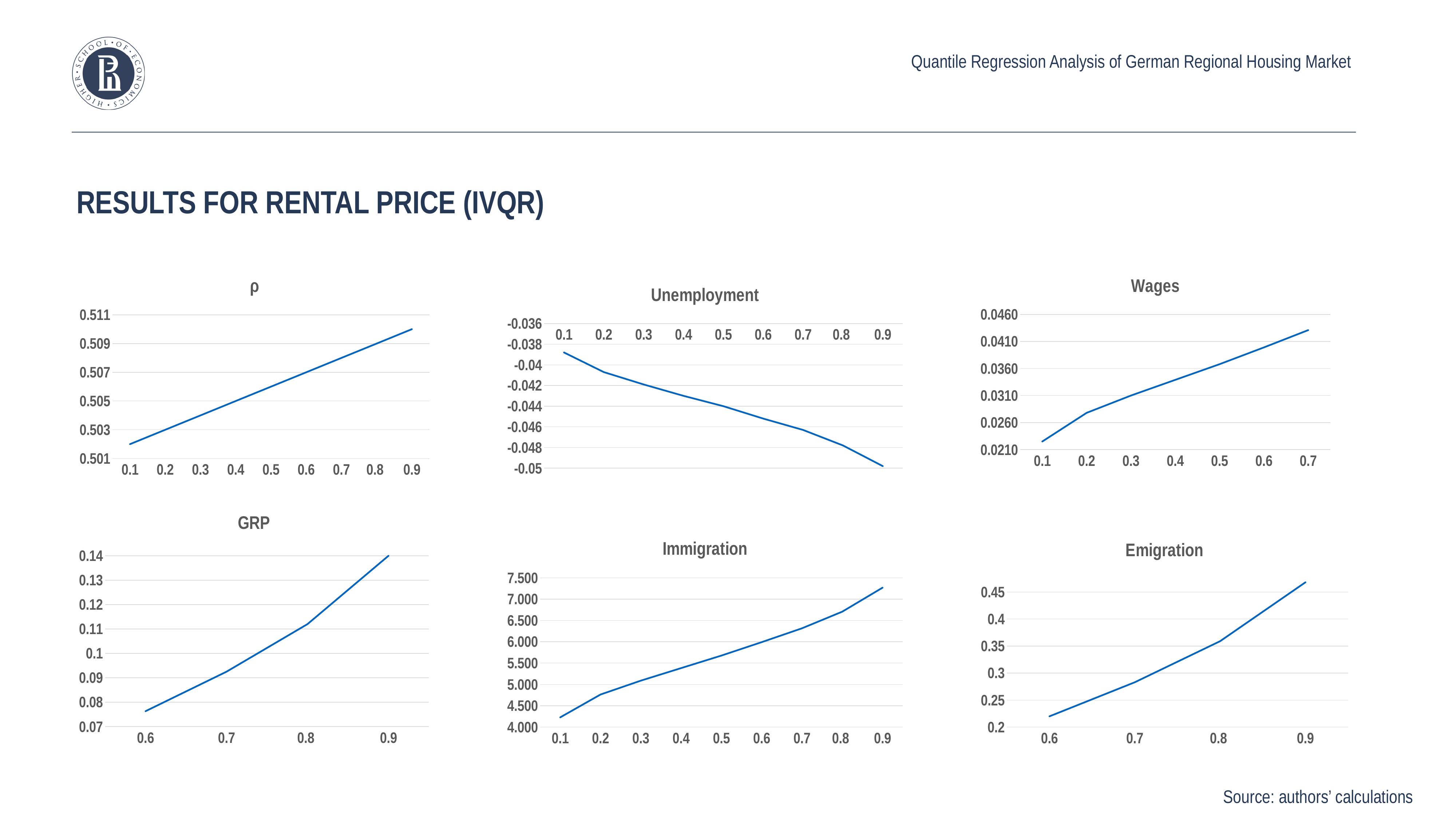
What kind of chart is the Unemployment chart? line chart In the Immigration chart, is the value at quantile 0.1 greater or less than 4.500? less In the Wages chart, how many quantile points are plotted on the x axis? 7 How many charts are shown on the slide? 6 In the Emigration chart, is the value at quantile 0.6 greater or less than 0.25? less In the Unemployment chart, do the values rise or fall along the x axis? fall In the Unemployment chart, which quantile has the lowest value? 0.9 In the Emigration chart, which quantile has the highest value? 0.9 In the GRP chart, what is the value at quantile 0.9? 0.14 In the GRP chart, how many points are plotted? 4 In the Immigration chart, is the value at quantile 0.9 greater or less than 7.000? greater In the ρ chart, do the values rise or fall as the quantile increases from 0.1 to 0.9? rise